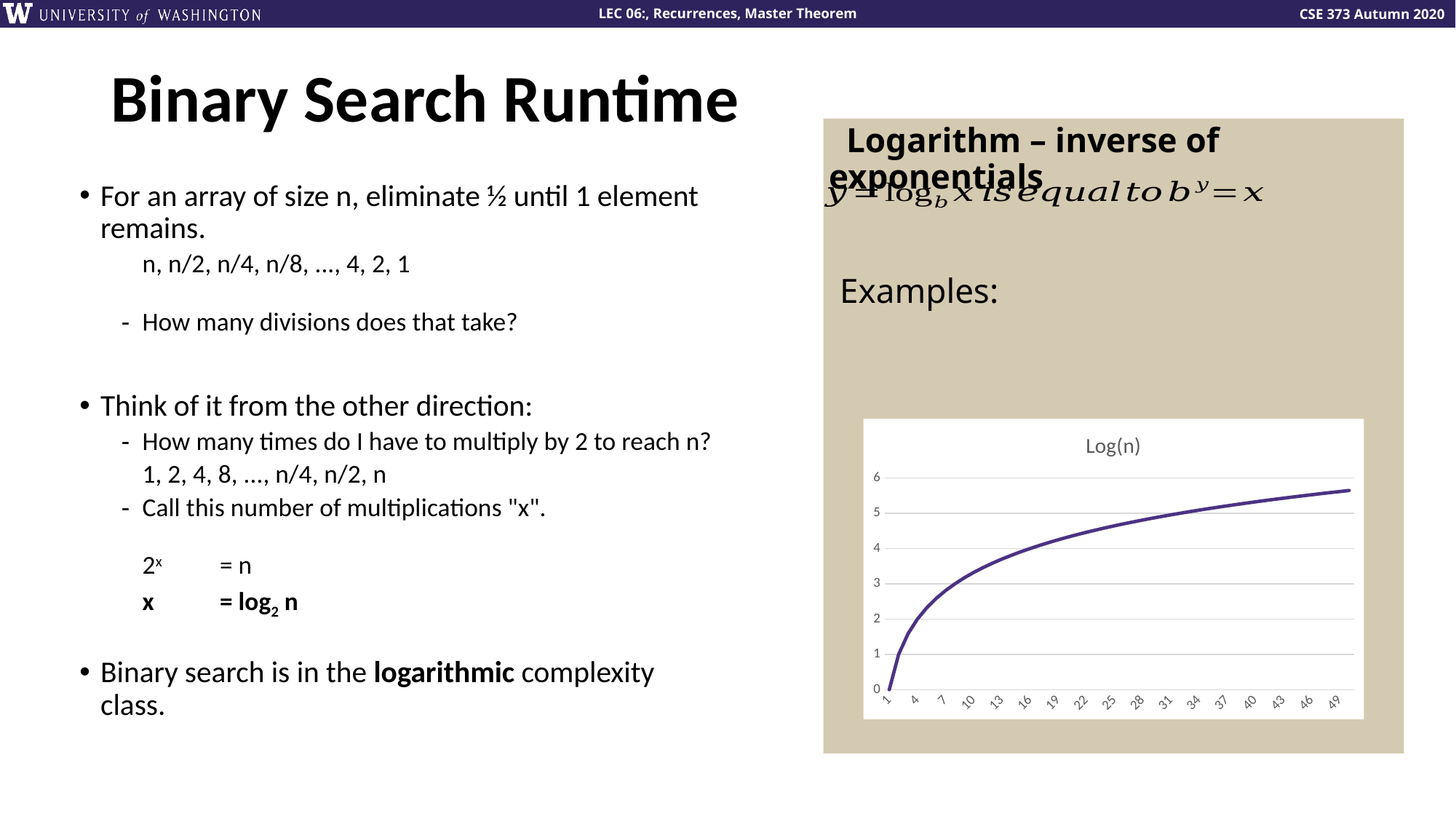
In the Log(n) chart, is the value at n = 25 greater or less than 4? greater What is the highest value shown on the y axis of the Log(n) chart? 6 In the Log(n) chart, is the value at n = 49 greater or less than 6? less In the Log(n) chart, is the value at n = 49 greater or less than 5? greater What kind of chart is the Log(n) chart? line chart At which x-axis value does the Log(n) chart have its lowest point? 1 Do the values in the Log(n) chart rise or fall as n increases along the x axis? rise What is the title of the chart on the slide? Log(n) In the Log(n) chart, which is larger: the value at n = 13 or the value at n = 40? n = 40